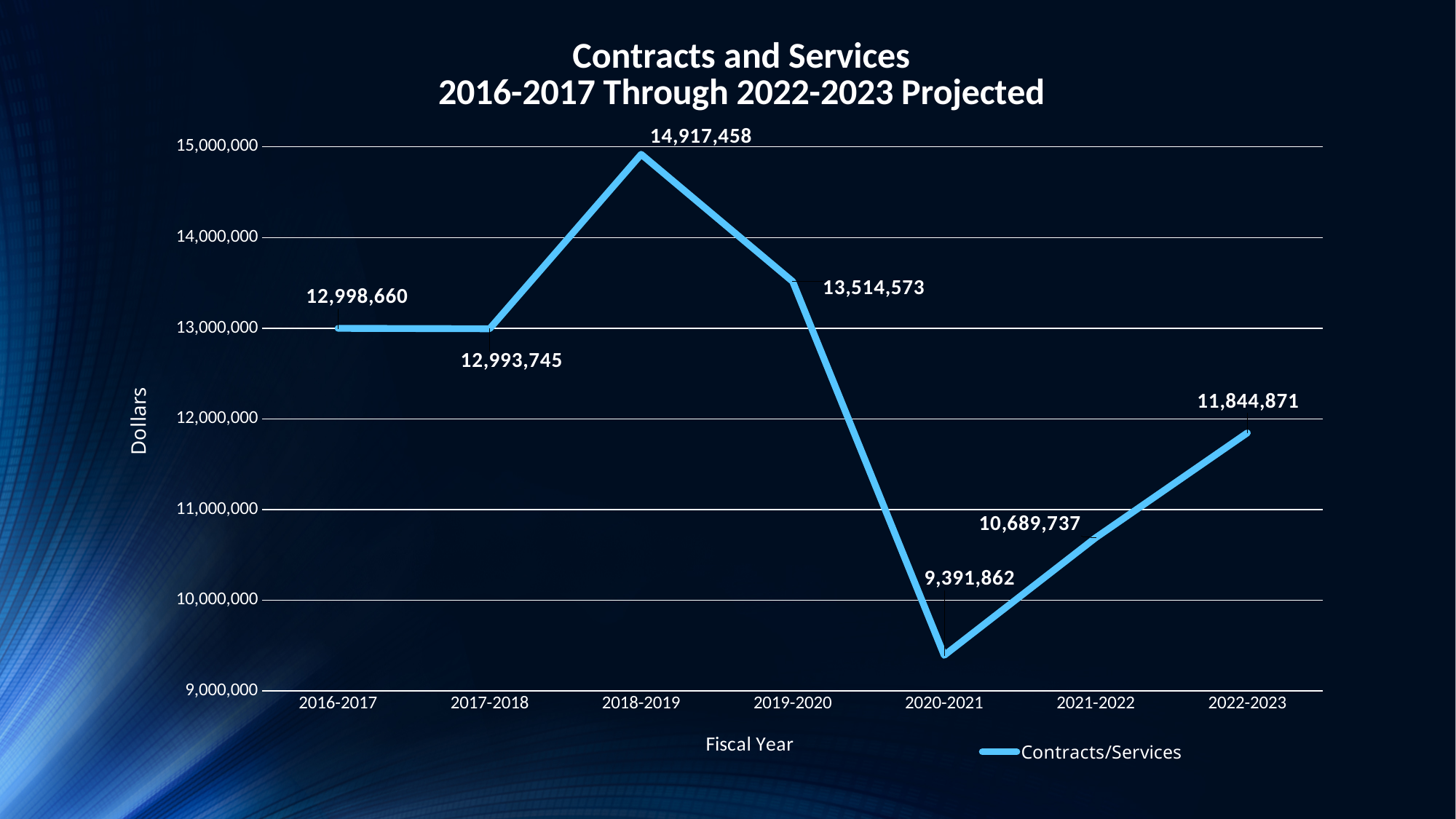
What is the projected value for 2022-2023? 11,844,871 Is the value for 2021-2022 greater or less than 11,000,000? less What is the value for 2018-2019? 14,917,458 Which fiscal year has the lowest value? 2020-2021 Which fiscal year has the highest value? 2018-2019 What is the difference between the 2022-2023 value and the 2021-2022 value? 1,155,134 What is the difference between the 2018-2019 value and the 2020-2021 value? 5,525,596 Which is larger, the value for 2019-2020 or the value for 2021-2022? 2019-2020 What is the value for 2019-2020? 13,514,573 How many fiscal years are plotted on the chart? 7 What is the value for 2020-2021? 9,391,862 What kind of chart is shown on the slide? line chart